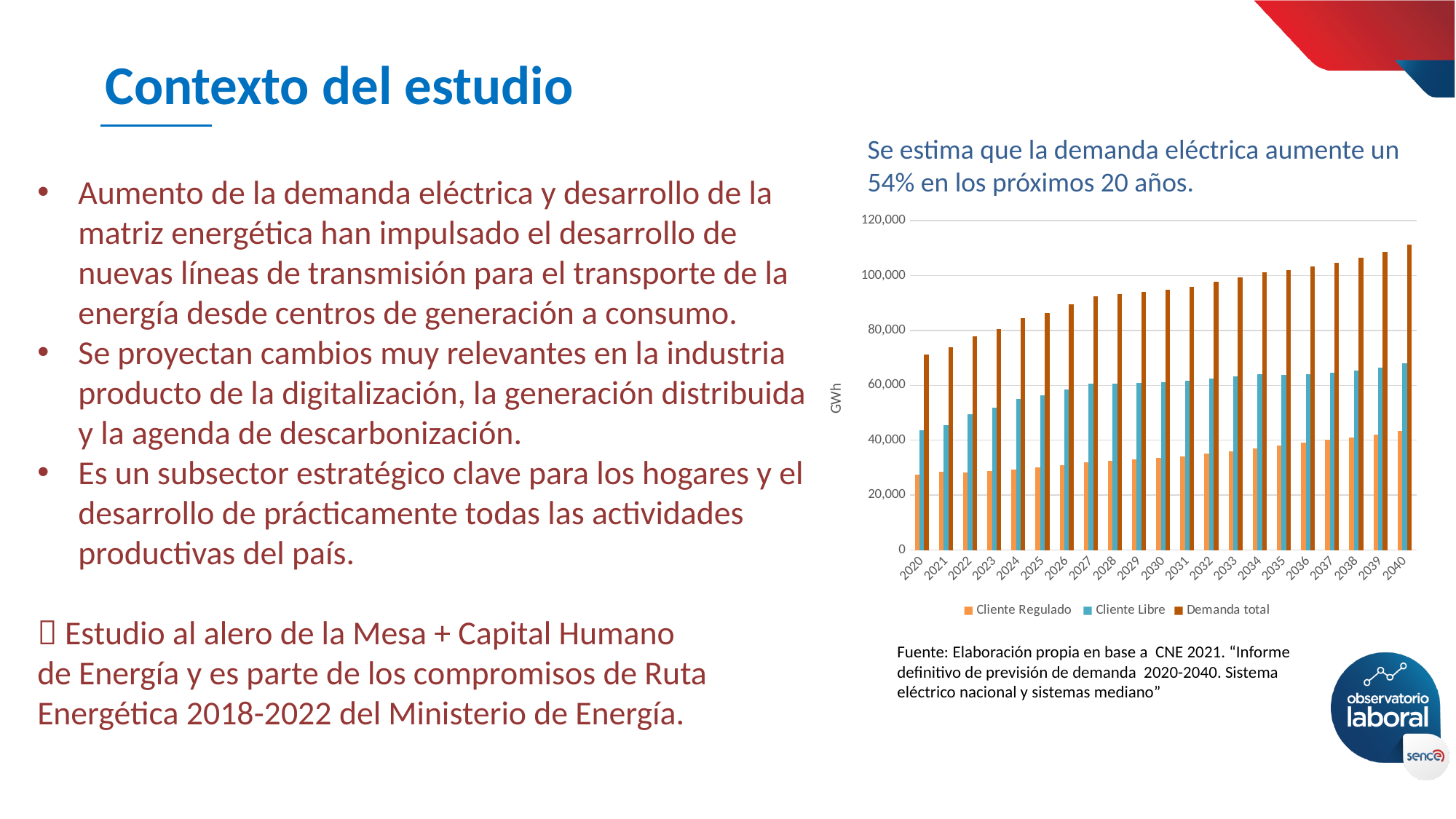
Is the value for Cliente Regulado in 2020 greater or less than 40,000? less Does Demanda total rise or fall from 2020 to 2040? rise Is the value for Demanda total in 2040 greater or less than 100,000? greater How many series does the chart legend list? 3 Is the value for Demanda total in 2020 greater or less than 80,000? less What kind of chart is shown on the slide? bar chart In which year is Demanda total highest? 2040 What unit is shown on the y axis of the chart? GWh In which year is Demanda total lowest? 2020 In 2020, which is larger: Cliente Libre or Cliente Regulado? Cliente Libre How many years are plotted along the x axis of the chart? 21